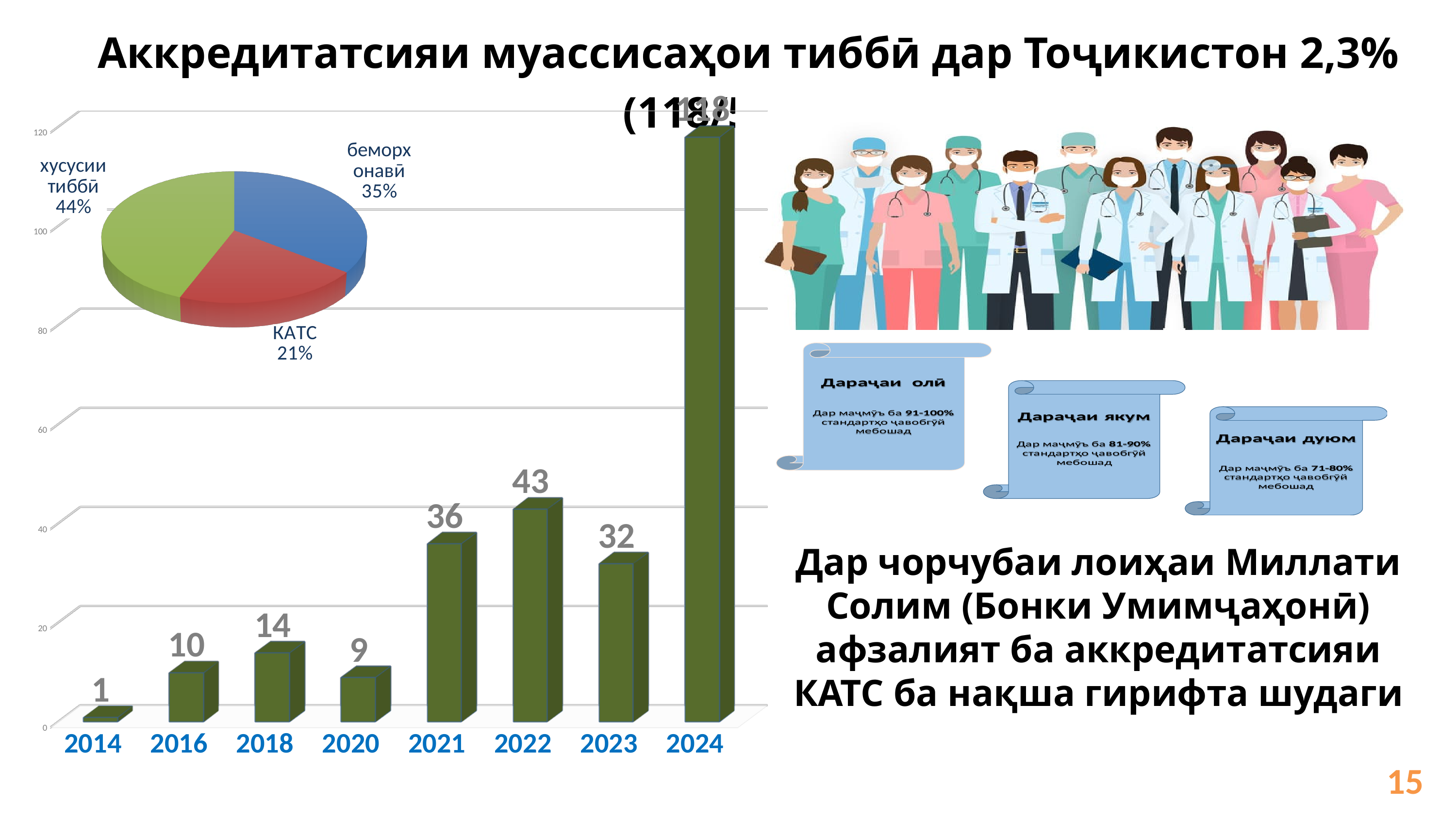
How many years are shown on the x axis of the bar chart? 8 In the bar chart, is the value for 2024 greater or less than 100? greater In the bar chart, which year has the highest value? 2024 In the pie chart, which slice is the largest? хусусии тиббӣ In the bar chart, which year has the lowest value? 2014 In the bar chart, what is the difference between the values for 2022 and 2021? 7 In the bar chart, what is the value for 2020? 9 In the bar chart, which is larger, the value for 2023 or the value for 2022? 2022 In the bar chart, what is the value for 2022? 43 In the bar chart, what is the value for 2016? 10 What kind of chart is the chart with the years on the x axis? bar chart In the pie chart, what share does КАТС have? 21%